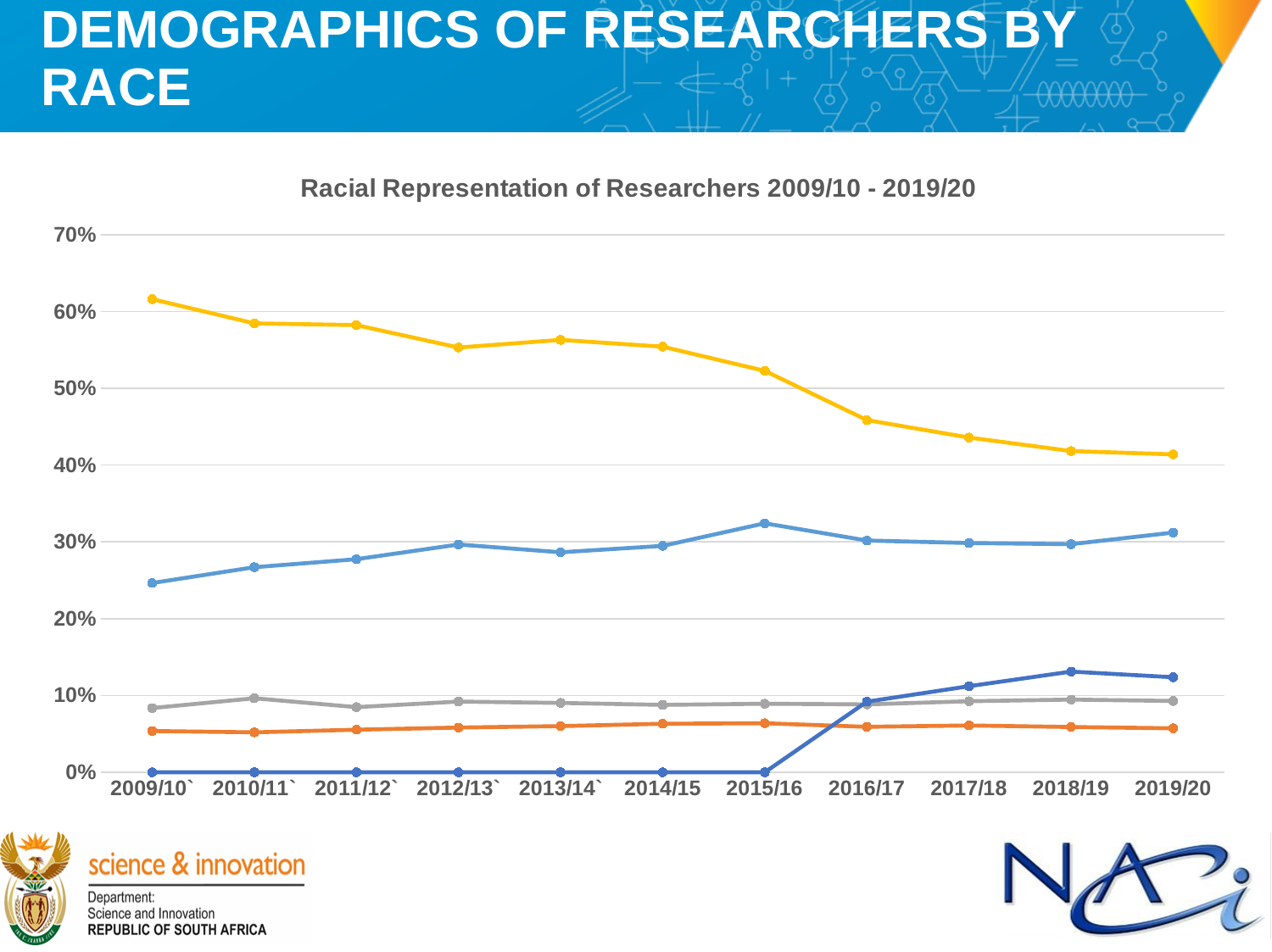
What kind of chart is shown on the slide? line chart Is the value of the yellow line for 2009/10 greater or less than 60%? greater Is the value of the dark blue line for 2018/19 greater or less than 10%? greater Is the value of the orange line for 2014/15 greater or less than 10%? less How many years are plotted along the x axis of the chart? 11 In which year is the yellow line at its highest? 2009/10` What is the title of the chart? Racial Representation of Researchers 2009/10 - 2019/20 Does the yellow line rise or fall from 2009/10 to 2019/20? fall What value does the dark blue line show for 2012/13? 0% In 2019/20, which line has the higher value, the yellow line or the light blue line? the yellow line